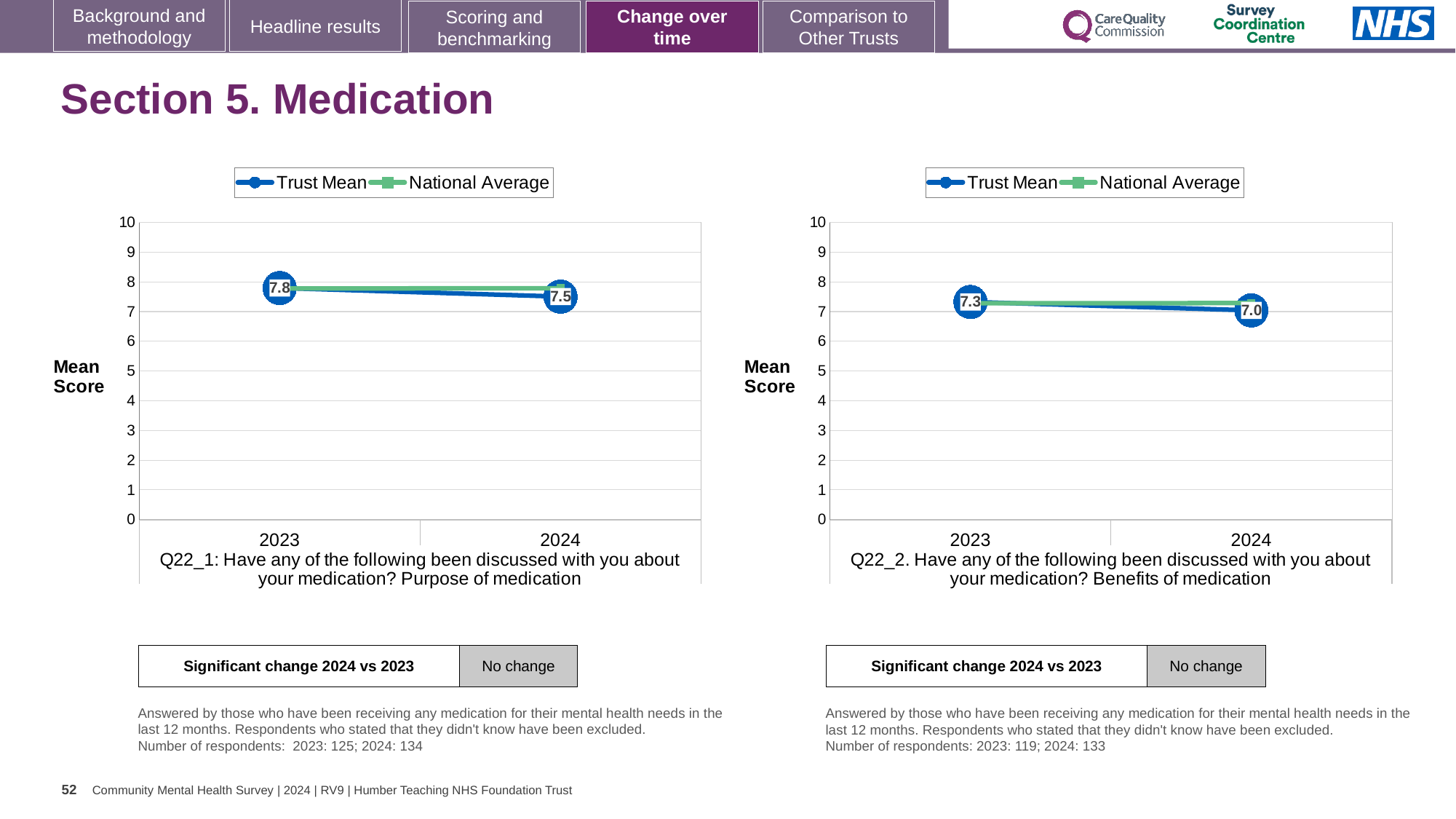
In the Q22_1 chart (Purpose of medication), what is the Trust Mean for 2023? 7.8 In the Q22_1 chart (Purpose of medication), does the Trust Mean rise or fall from 2023 to 2024? fall In the Q22_2 chart (Benefits of medication), is the Trust Mean for 2024 greater or less than 8? less In the Q22_2 chart (Benefits of medication), what is the difference between the Trust Mean in 2023 and 2024? 0.3 In the Q22_2 chart (Benefits of medication), what is the Trust Mean for 2024? 7.0 In the Q22_1 chart (Purpose of medication), by how much did the Trust Mean change from 2023 to 2024? 0.3 How many years are plotted on the x axis of the Q22_2 chart (Benefits of medication)? 2 In the Q22_1 chart (Purpose of medication), what is the Trust Mean for 2024? 7.5 In the Q22_2 chart (Benefits of medication), what is the Trust Mean for 2023? 7.3 What kind of chart is the Q22_1 chart (Purpose of medication)? line chart In the Q22_1 chart (Purpose of medication), which year has the higher Trust Mean, 2023 or 2024? 2023 How many series does the legend of the Q22_2 chart (Benefits of medication) list? 2